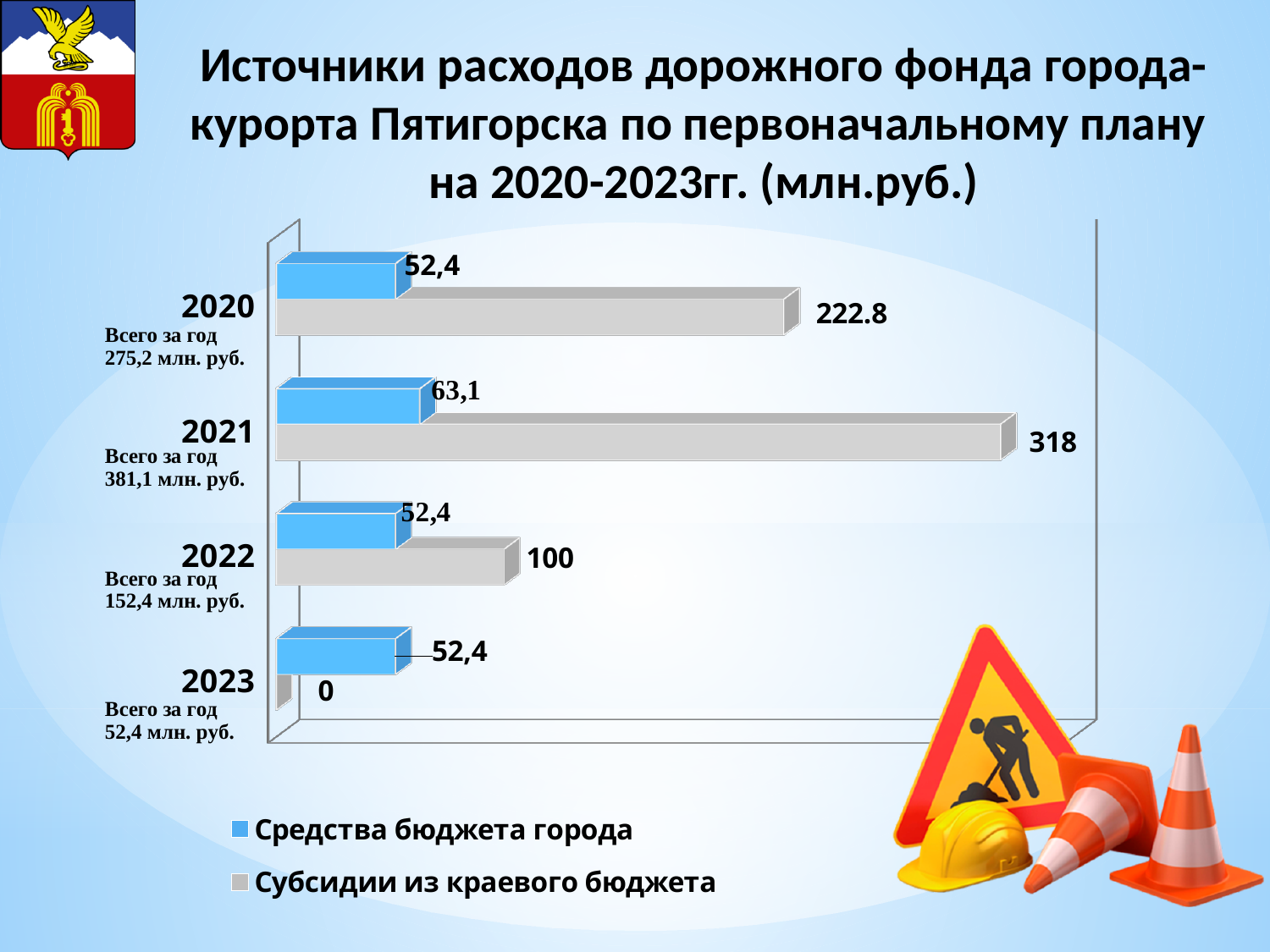
Which is larger for 2022: Средства бюджета города or Субсидии из краевого бюджета? Субсидии из краевого бюджета What is the value of Субсидии из краевого бюджета for 2023? 0 What is the value of Средства бюджета города for 2021? 63,1 What is the difference between Субсидии из краевого бюджета for 2021 and for 2022? 218 What is the value of Субсидии из краевого бюджета for 2021? 318 In which year is the value of Субсидии из краевого бюджета the lowest? 2023 In which year is the value of Субсидии из краевого бюджета the highest? 2021 How many series does the legend list? 2 How many years (categories) are shown on the chart? 4 What is the total for the year 2021 as printed on the slide? 381,1 млн. руб. What type of chart is shown on the slide? bar chart What is the value of Субсидии из краевого бюджета for 2020? 222.8